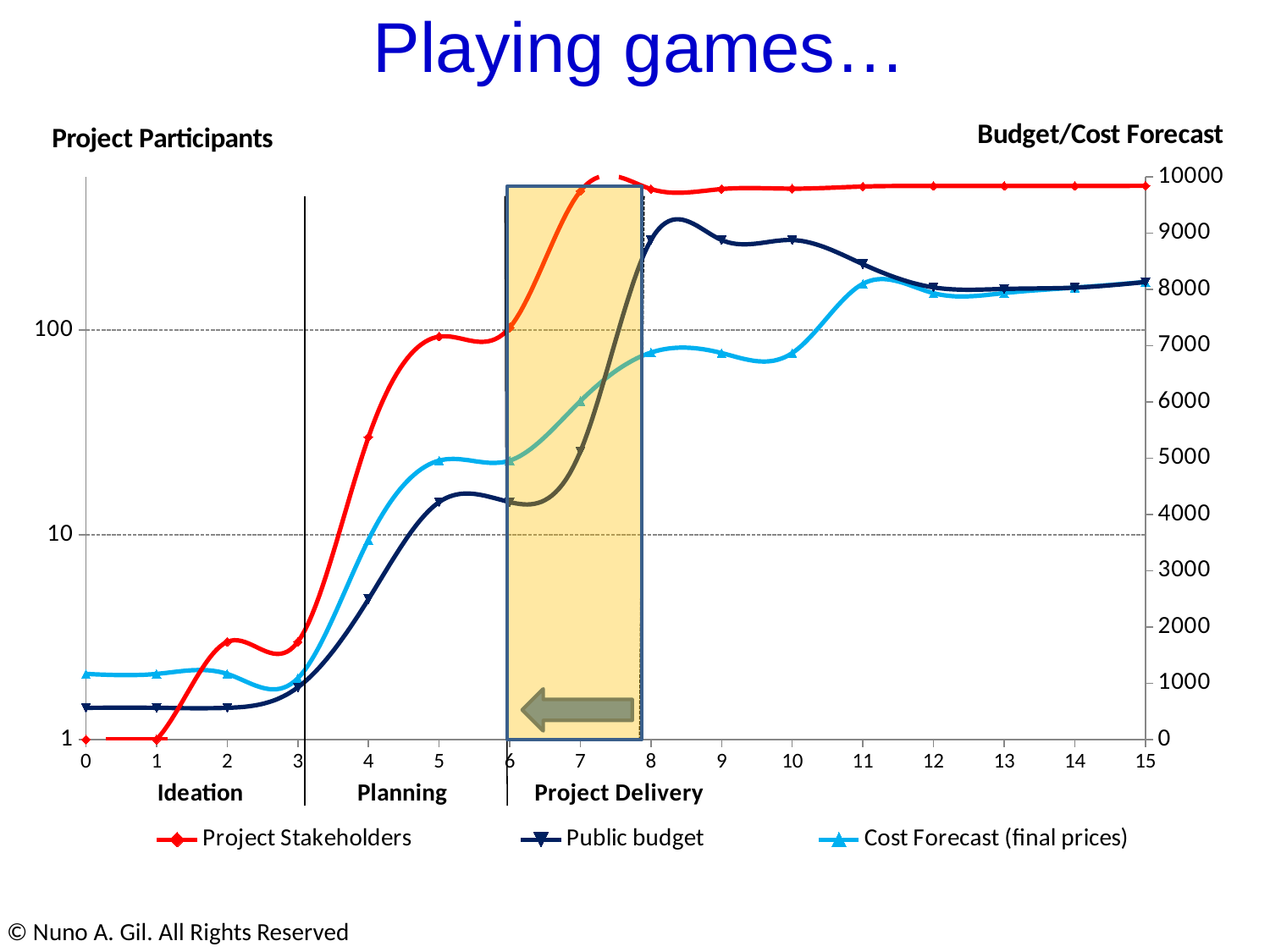
How many series does the legend list? 3 Is the value of Public budget at x = 9 greater or less than 8000? greater At x = 9, which is larger: Public budget or Cost Forecast (final prices)? Public budget What kind of chart is shown on the slide? line chart At x = 4, which is larger: Public budget or Cost Forecast (final prices)? Cost Forecast (final prices) Does the Project Stakeholders series rise or fall overall from x = 0 to x = 15? rise Is the value of Cost Forecast (final prices) at x = 7 greater or less than 5000? greater Is the value of Public budget at x = 0 greater or less than 1000? less What are the three project phases labelled along the x axis? Ideation, Planning, Project Delivery What is the title of the right-hand vertical axis? Budget/Cost Forecast What is the value of Project Stakeholders at x = 0? 1